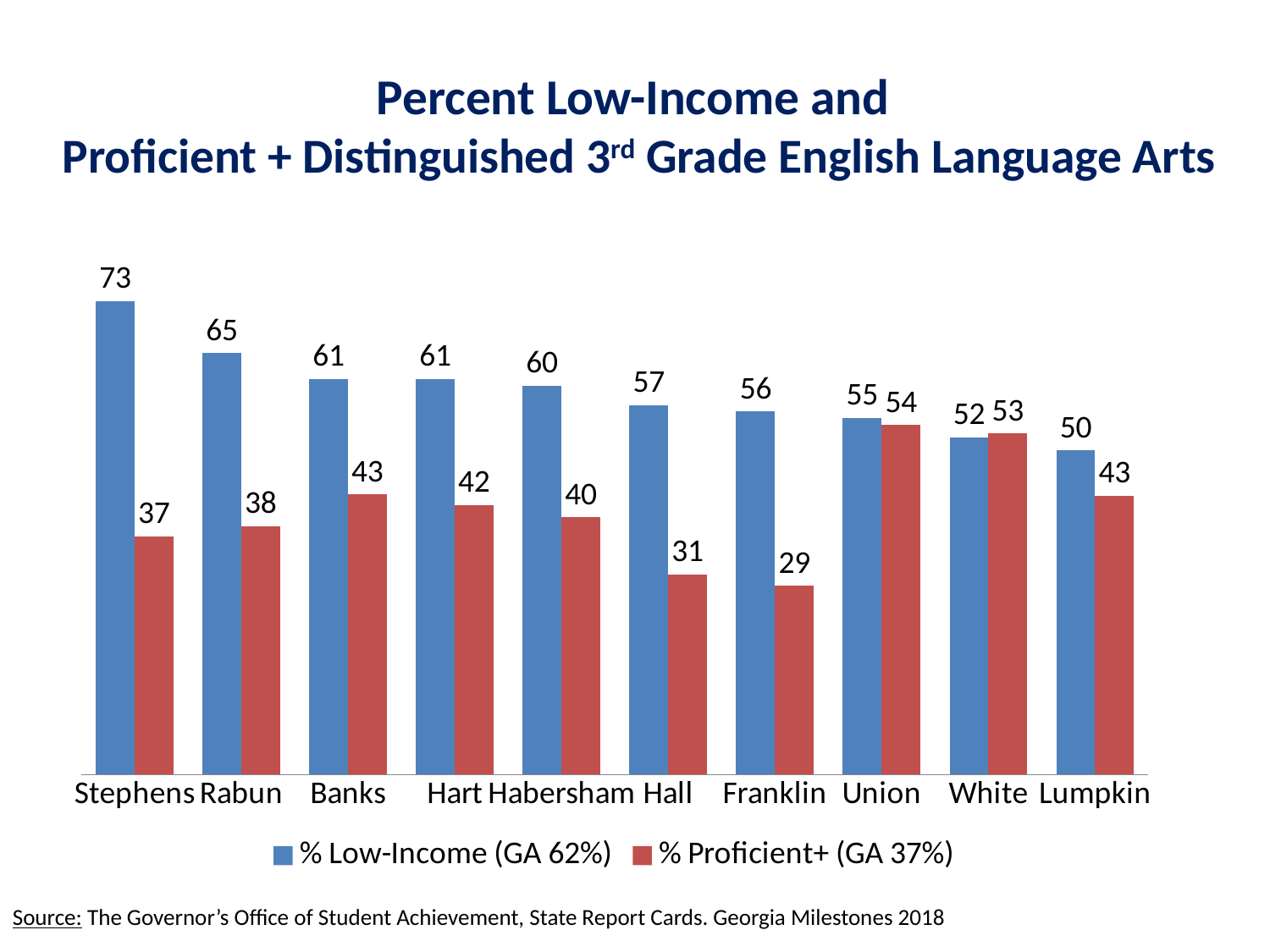
Which is larger for White: the % Low-Income value or the % Proficient+ value? % Proficient+ What kind of chart is shown on the slide? Bar chart Which county has the lowest % Proficient+ value? Franklin What Georgia statewide value is given in the legend for % Proficient+? 37% How many counties are shown on the x axis? 10 Which county has the highest % Low-Income value? Stephens What is the % Low-Income value for Stephens? 73 What is the % Proficient+ value for Franklin? 29 Do the % Low-Income values rise or fall from Stephens to Lumpkin along the x axis? Fall What is the difference between the % Low-Income and % Proficient+ values for Hall? 26 What is the % Proficient+ value for Union? 54 How many series does the legend list? 2